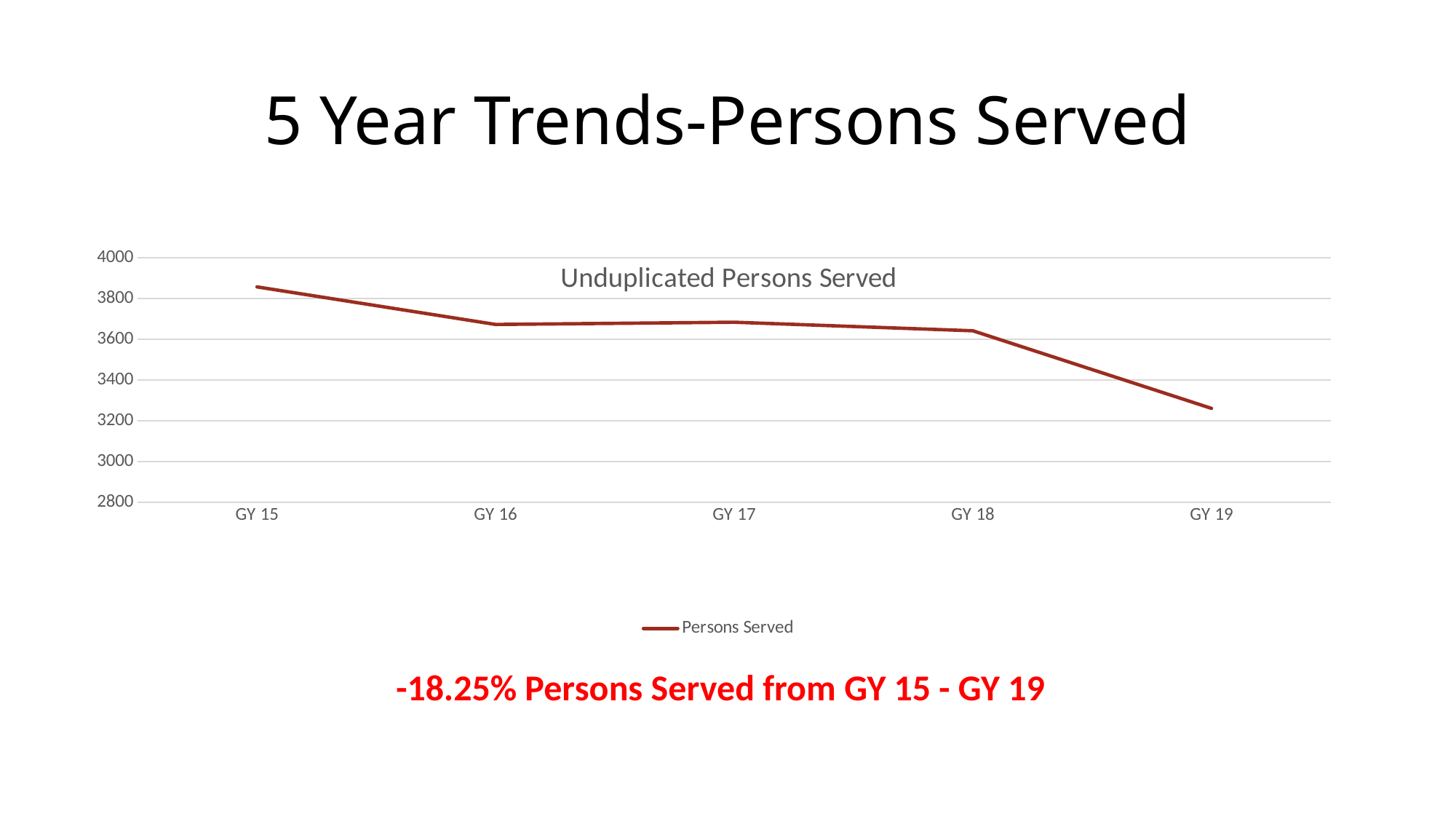
Which year has the lowest number of persons served? GY 19 What percentage change in persons served from GY 15 to GY 19 is stated on the slide? -18.25% What is the title of the chart? Unduplicated Persons Served Which is larger, the value for GY 18 or the value for GY 19? GY 18 How many series does the legend list? 1 How many points are plotted on the line? 5 Which year has the highest number of persons served? GY 15 What kind of chart is shown on the slide? line chart Is the value for GY 19 greater or less than 3400? less Do the values generally rise or fall from GY 15 to GY 19? fall Is the value for GY 16 greater or less than 3600? greater Is the value for GY 15 greater or less than 3800? greater